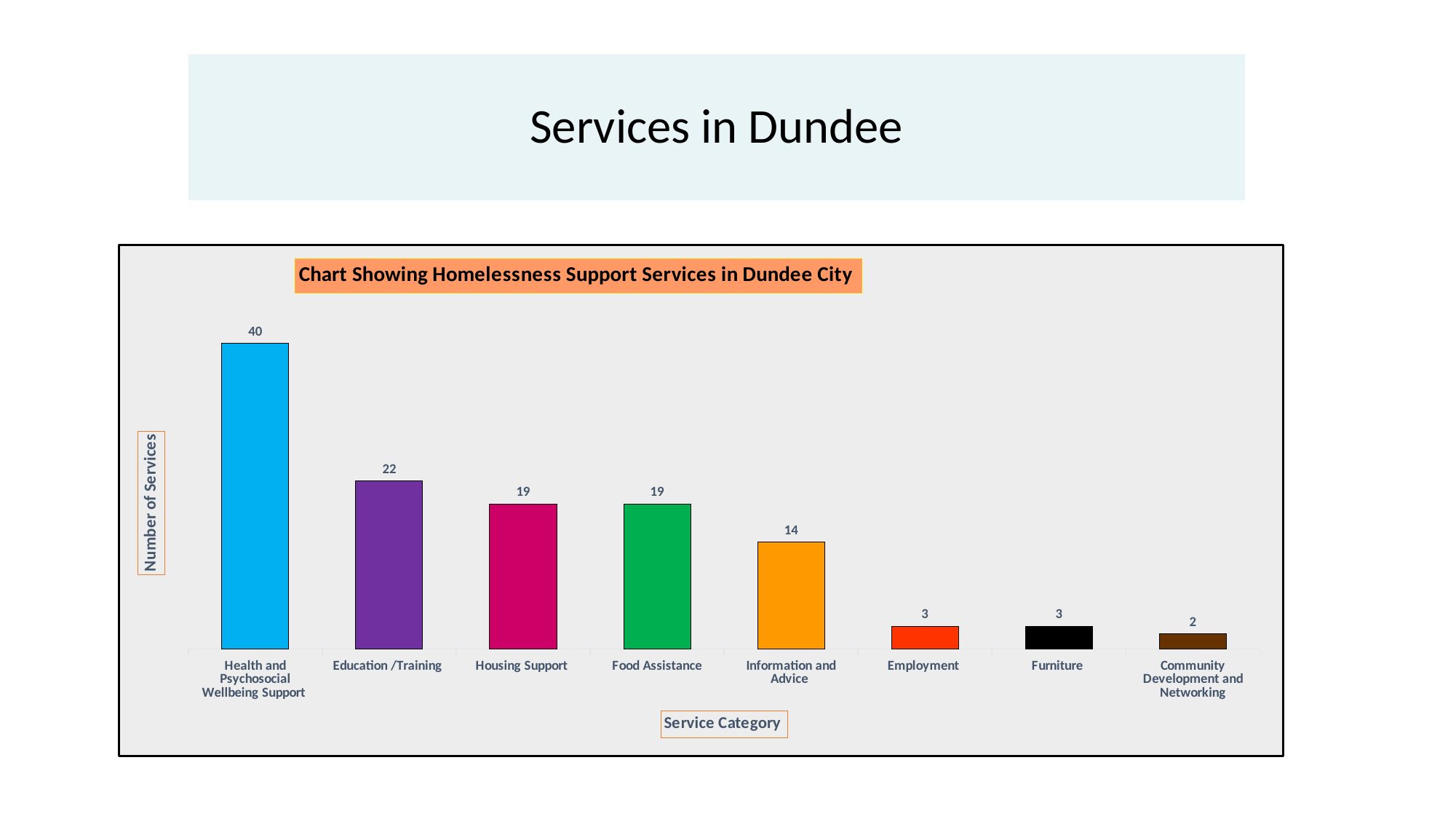
What is the difference between the number of services for Food Assistance and Information and Advice? 5 What is the number of services for Community Development and Networking? 2 Which service category has the lowest number of services? Community Development and Networking How many service categories are shown in the chart? 8 Which has more services, Education /Training or Housing Support? Education /Training What is the difference between the number of services for Health and Psychosocial Wellbeing Support and Education /Training? 18 What is the number of services for Information and Advice? 14 What is the title of the chart? Chart Showing Homelessness Support Services in Dundee City Which service category has the highest number of services? Health and Psychosocial Wellbeing Support Do the values rise or fall from left to right across the categories? Fall What is the number of services for Education /Training? 22 What kind of chart is shown on the slide? Bar chart